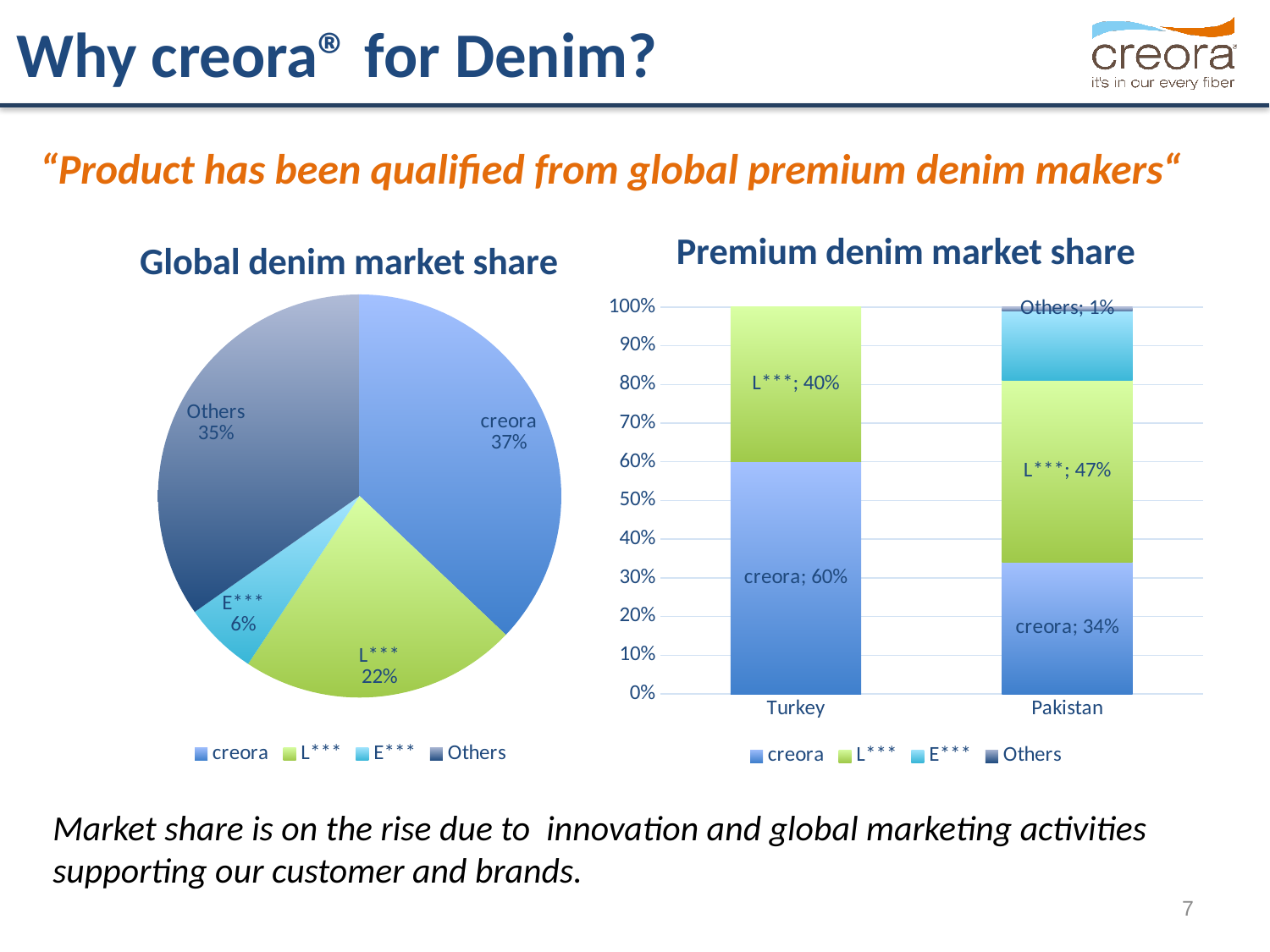
In the Global denim market share pie chart, which category has the largest slice? creora In the Premium denim market share chart, is the E*** share for Pakistan greater or less than 10%? greater In the Global denim market share pie chart, what share does creora hold? 37% In the Premium denim market share chart, what is the difference between the creora share for Turkey and the creora share for Pakistan? 26 percentage points In the Premium denim market share chart, what is the creora share for Turkey? 60% How many slices does the Global denim market share pie chart have? 4 How many series does the legend of the Premium denim market share chart list? 4 What kind of chart is the Global denim market share chart? Pie chart In the Global denim market share pie chart, what is the difference between the creora share and the Others share? 2 percentage points In the Premium denim market share chart, what is the L*** share for Pakistan? 47% In the Premium denim market share chart, is the creora share larger for Turkey or for Pakistan? Turkey In the Global denim market share pie chart, which category has the smallest slice? E***